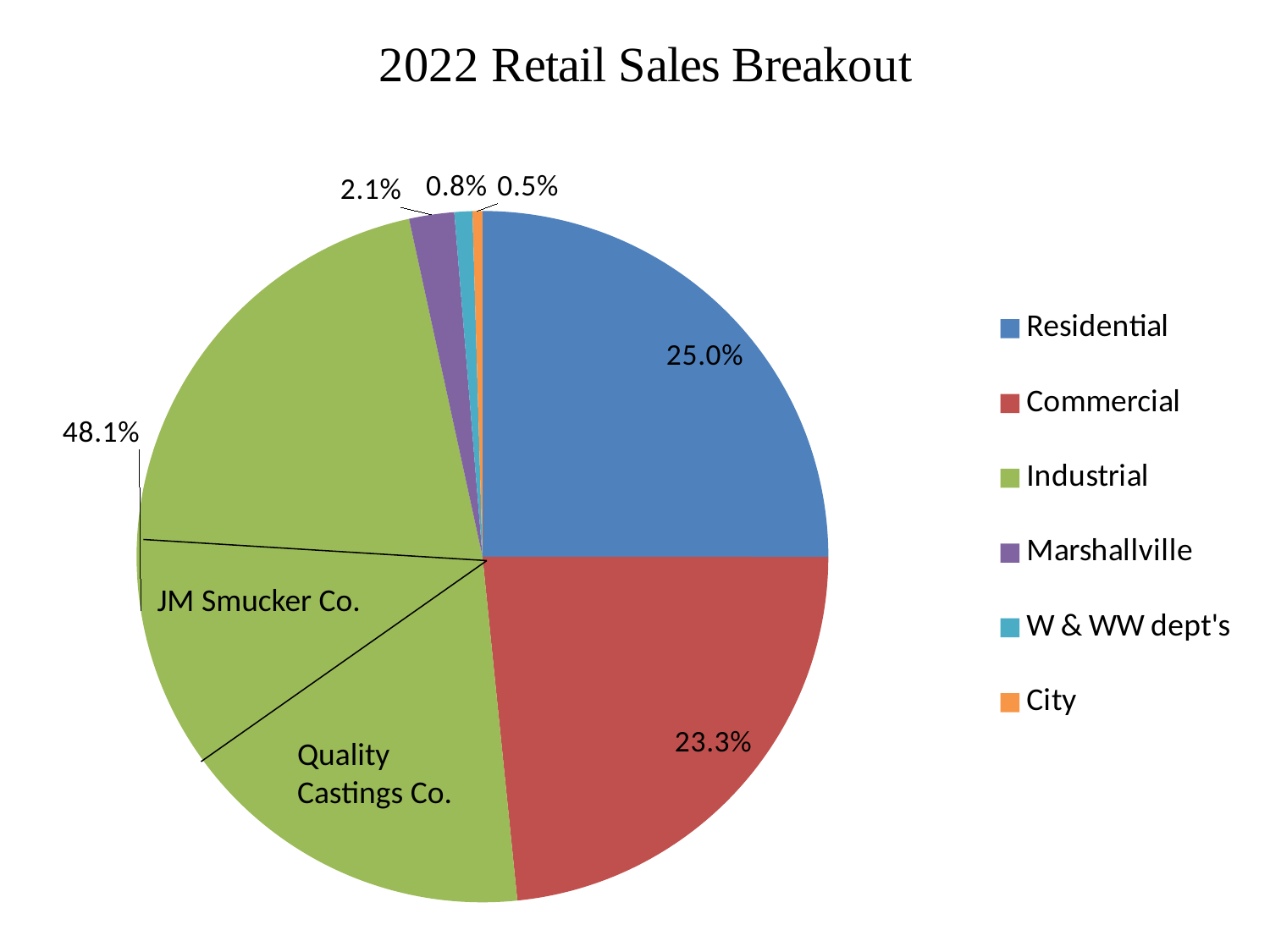
What is the title of the chart? 2022 Retail Sales Breakout What kind of chart is shown on the slide? pie chart Which category has the smallest slice of the pie? City What is the value shown for Residential? 25.0% Which is larger, the Marshallville slice or the W & WW dept's slice? Marshallville How many categories does the legend list? 6 What is the value shown for City? 0.5% What share of the pie does Industrial account for? 48.1% What is the value shown for Commercial? 23.3% What is the value shown for Marshallville? 2.1% What is the difference between the Residential and Commercial shares? 1.7% Which category has the largest slice of the pie? Industrial